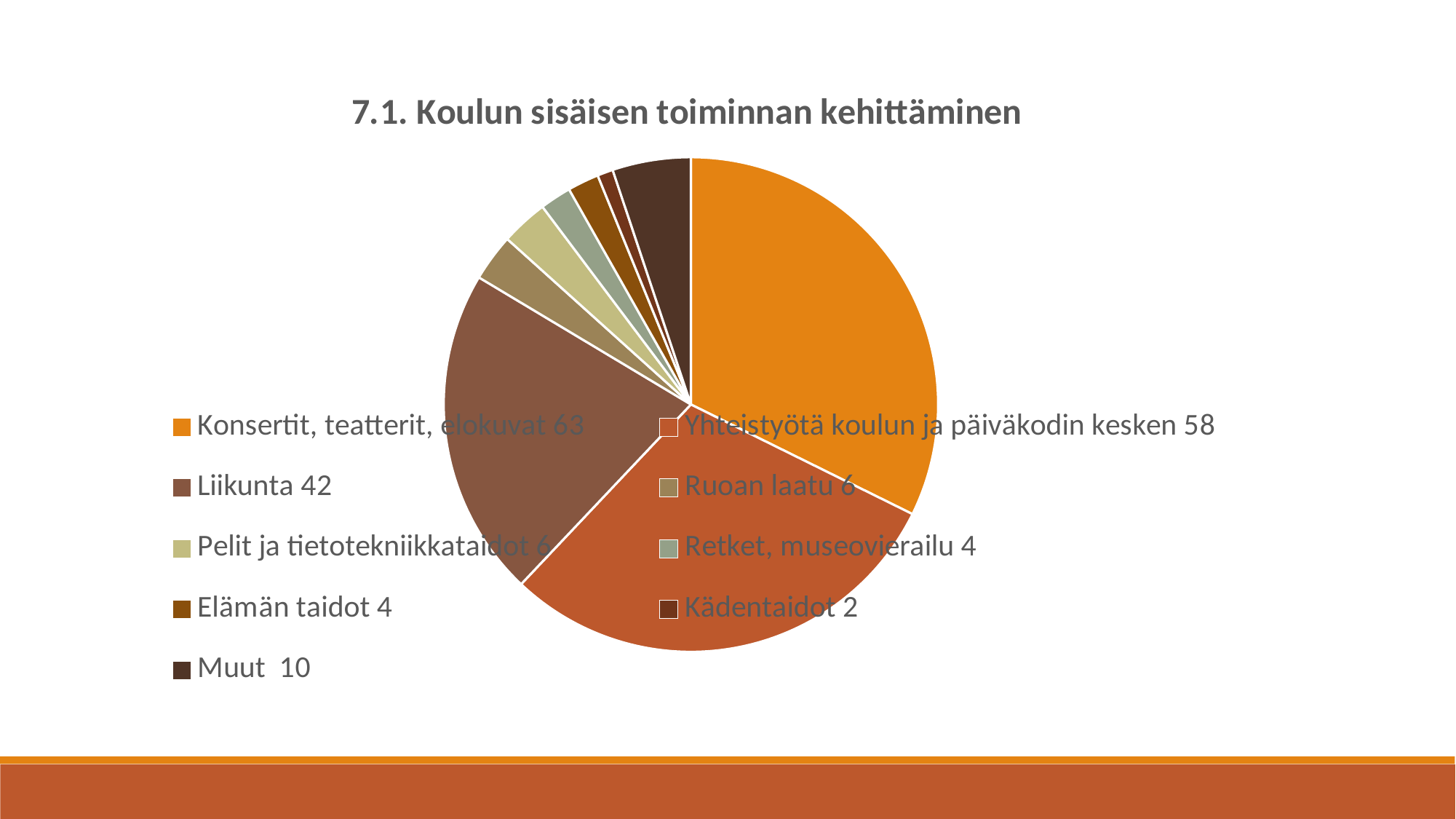
Which category has the smallest slice of the pie? Kädentaidot What is the value for Yhteistyötä koulun ja päiväkodin kesken? 58 What kind of chart is shown on the slide? pie chart What is the title of the chart? 7.1. Koulun sisäisen toiminnan kehittäminen What is the difference between the values for Konsertit, teatterit, elokuvat and Liikunta? 21 What is the value for Liikunta? 42 Which category has the largest slice of the pie? Konsertit, teatterit, elokuvat What is the value for Konsertit, teatterit, elokuvat? 63 How many categories does the pie chart have? 9 What is the total of all the values shown in the legend? 195 What is the value for Muut? 10 Which is larger, the value for Yhteistyötä koulun ja päiväkodin kesken or the value for Liikunta? Yhteistyötä koulun ja päiväkodin kesken